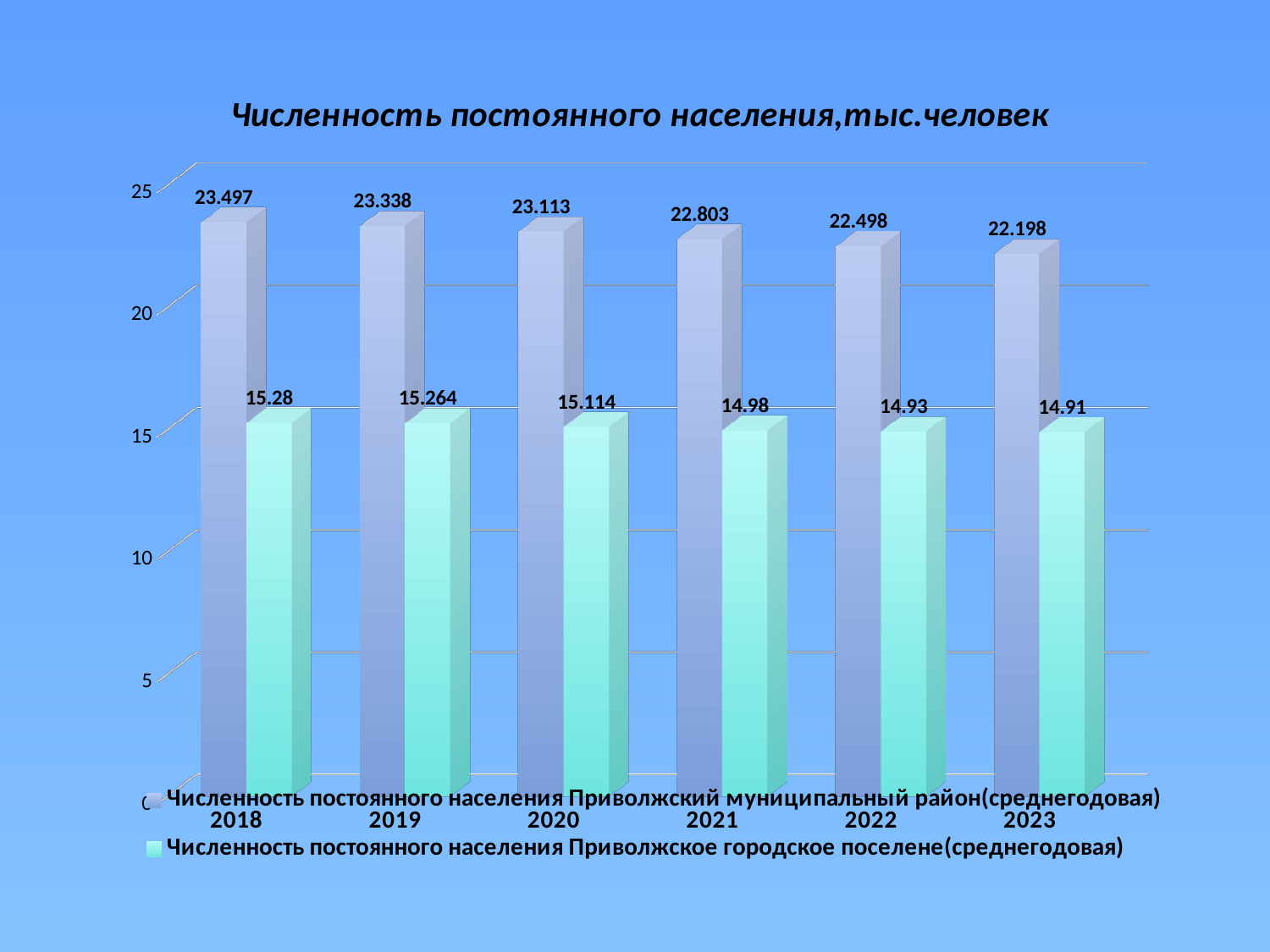
How many series does the legend list? 2 What is the value for Приволжский муниципальный район in 2021? 22.803 How many years are shown on the x axis? 6 Which year has the lowest value for Приволжский муниципальный район? 2023 What kind of chart is shown on the slide? bar chart Is the value for Приволжское городское поселение in 2020 greater or less than 15? greater What is the value for Приволжское городское поселение in 2023? 14.91 Which is larger: the Приволжский муниципальный район value in 2019 or in 2022? 2019 Which year has the highest value for Приволжское городское поселение? 2018 What is the difference between the Приволжский муниципальный район values in 2018 and 2023? 1.299 Do the values for Приволжский муниципальный район rise or fall from 2018 to 2023? fall What is the value for Приволжский муниципальный район in 2018? 23.497